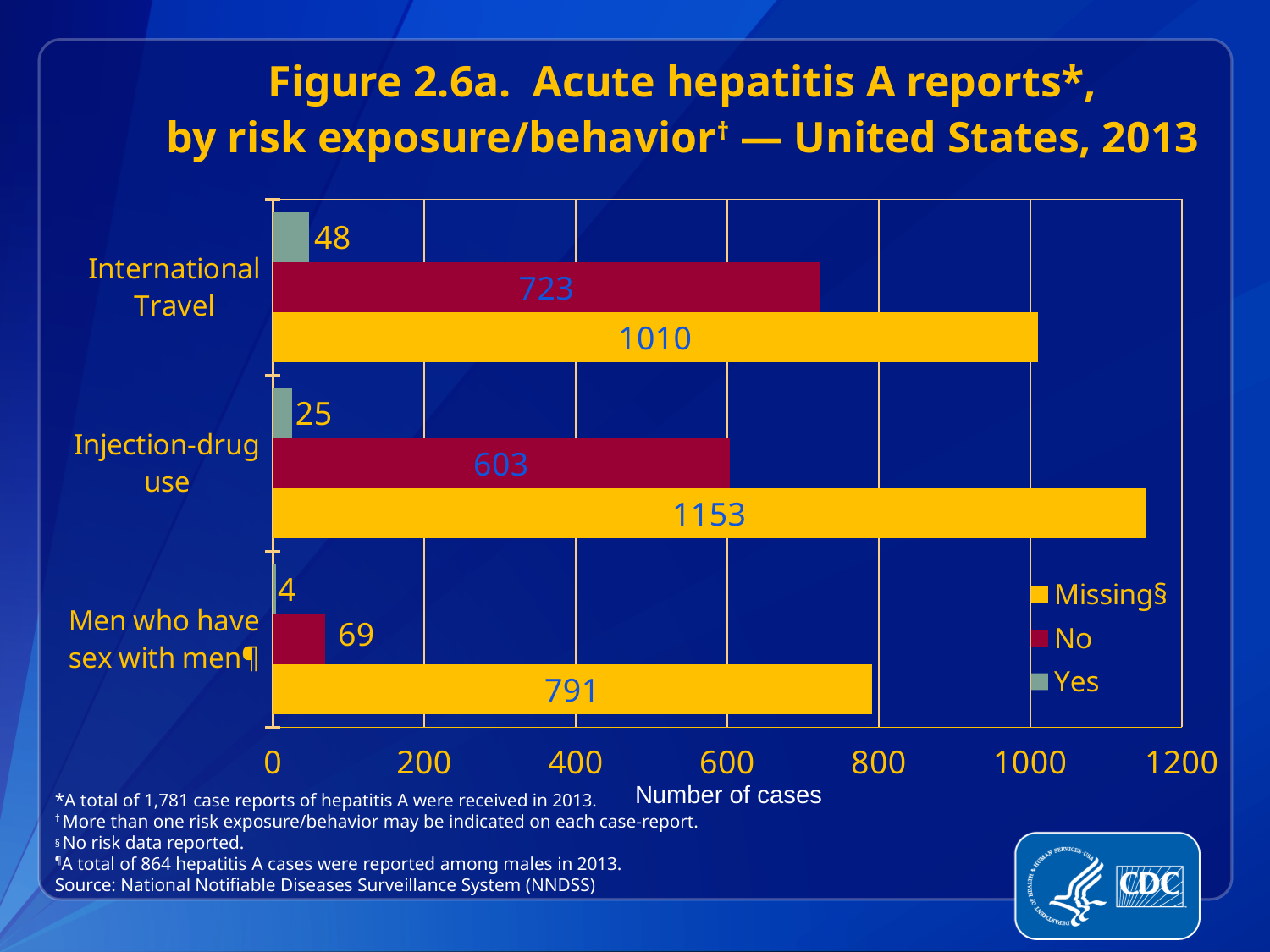
What is the "Missing" value for Injection-drug use? 1153 What kind of chart is shown on the slide? bar chart How many risk exposure/behavior categories are shown on the chart? 3 Which risk exposure/behavior has the highest "Missing" value? Injection-drug use What is the label of the x axis? Number of cases What is the difference between the "No" values for International Travel and Injection-drug use? 120 How many cases are reported as "Yes" for International Travel? 48 How many series does the legend list? 3 Which risk exposure/behavior has the lowest "Yes" value? Men who have sex with men How many cases are reported as "No" for Men who have sex with men? 69 Is the "No" value for Injection-drug use greater or less than 800? less Which is larger: the "Missing" value for International Travel or for Men who have sex with men? International Travel